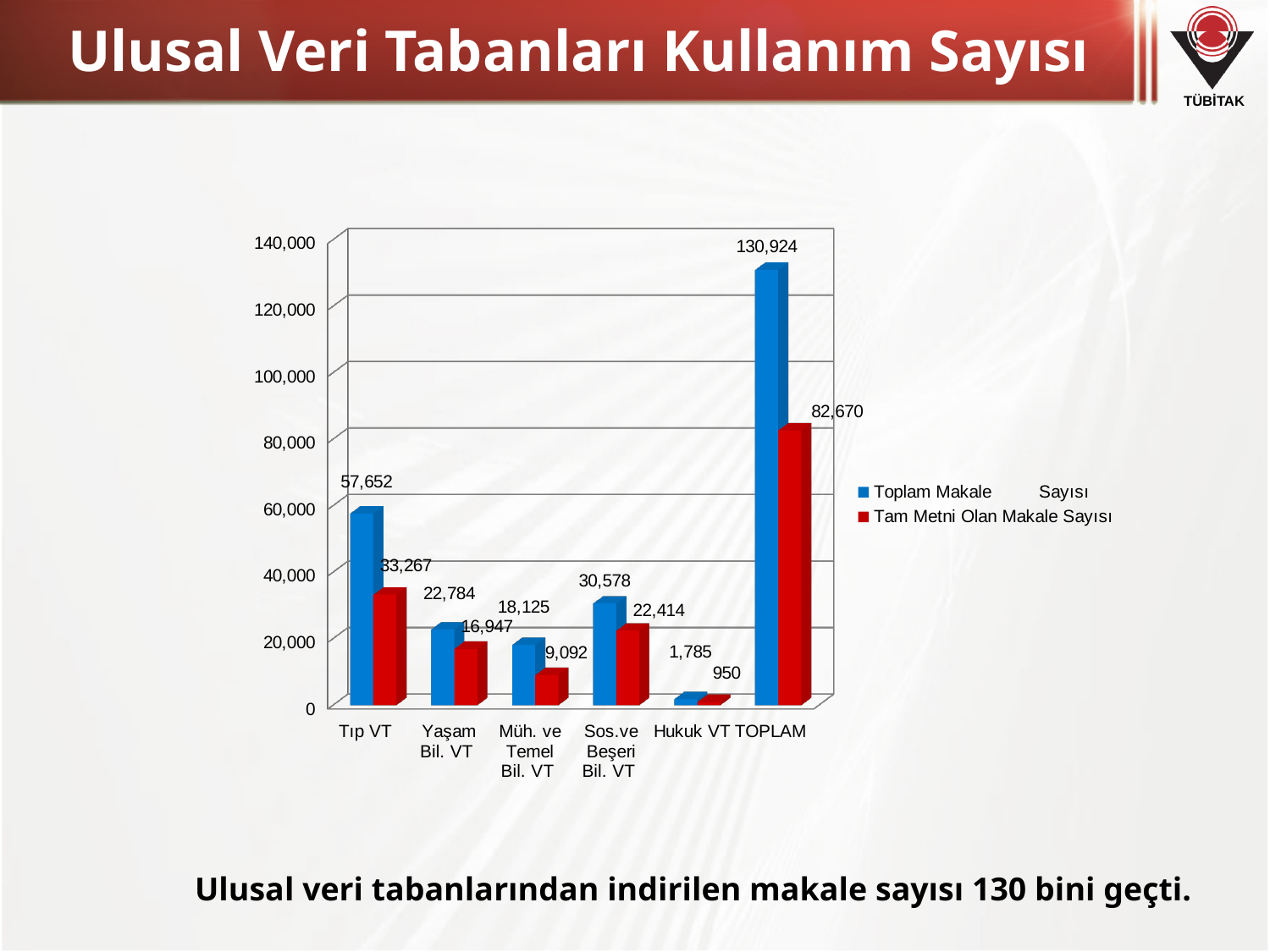
What is the Toplam Makale Sayısı value for TOPLAM? 130,924 What is the Toplam Makale Sayısı value for Tıp VT? 57,652 How many series does the legend list? 2 What is the Tam Metni Olan Makale Sayısı value for Sos.ve Beşeri Bil. VT? 22,414 What is the difference between Toplam Makale Sayısı and Tam Metni Olan Makale Sayısı for Müh. ve Temel Bil. VT? 9,033 Which is larger: the Toplam Makale Sayısı for Yaşam Bil. VT or for Sos.ve Beşeri Bil. VT? Sos.ve Beşeri Bil. VT Is the Tam Metni Olan Makale Sayısı value for TOPLAM greater or less than 80,000? greater Excluding TOPLAM, which category has the highest Tam Metni Olan Makale Sayısı? Tıp VT How many categories are shown on the x axis? 6 Excluding TOPLAM, which category has the lowest Toplam Makale Sayısı? Hukuk VT What kind of chart is shown on the slide? Bar chart What is the Tam Metni Olan Makale Sayısı value for Hukuk VT? 950